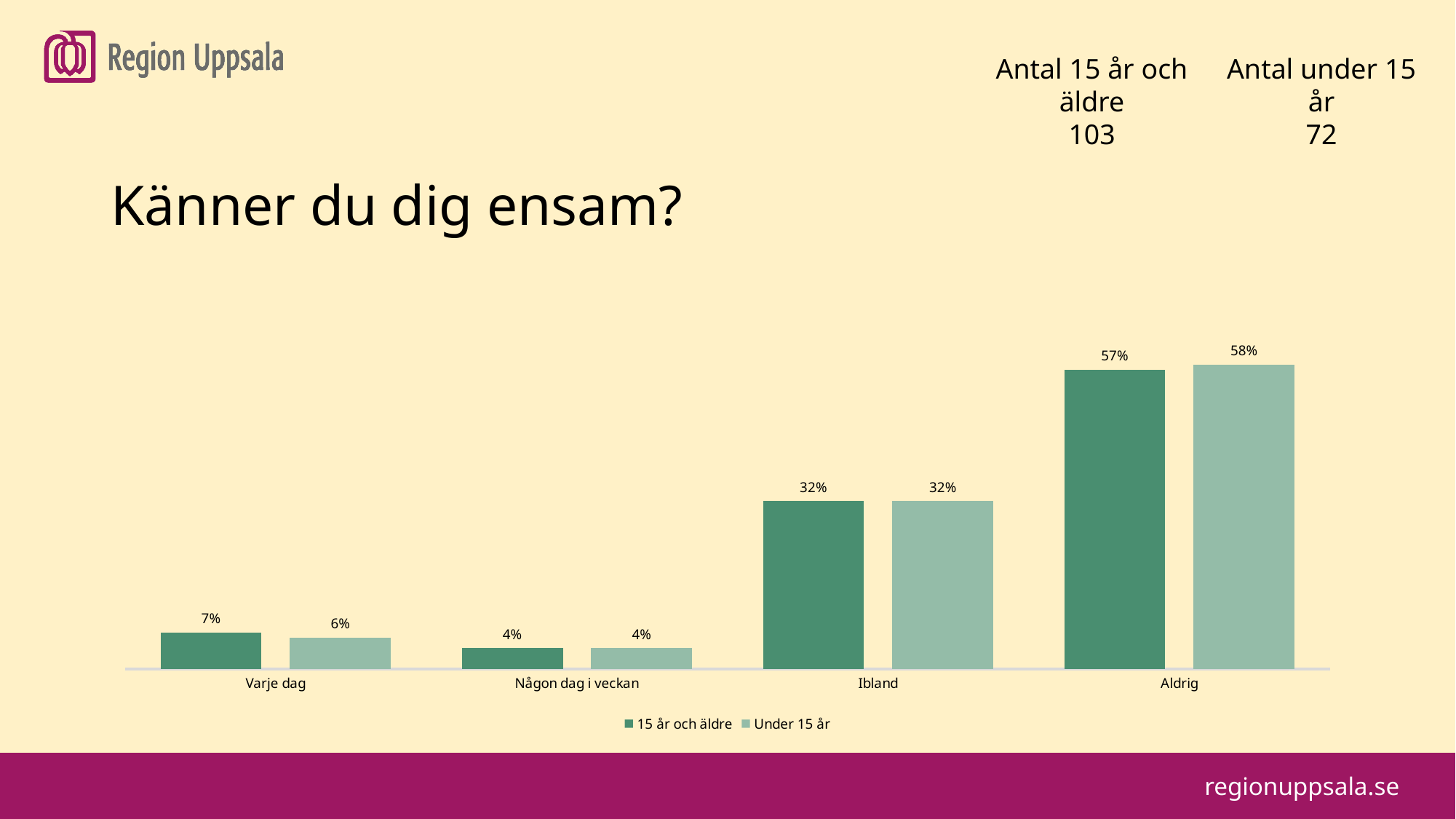
How many series does the legend list? 2 What are the two series named in the legend? 15 år och äldre; Under 15 år What is the difference between the 'Aldrig' and 'Ibland' values for '15 år och äldre'? 25% What is the value for '15 år och äldre' in the 'Aldrig' category? 57% Which category has the lowest value for 'Under 15 år'? Någon dag i veckan How many categories are shown on the x axis? 4 Which is larger: the 'Ibland' value or the 'Varje dag' value for 'Under 15 år'? Ibland Which category has the highest value for '15 år och äldre'? Aldrig What is the value for 'Under 15 år' in the 'Ibland' category? 32% What is the difference between the '15 år och äldre' and 'Under 15 år' values in the 'Varje dag' category? 1% What kind of chart is shown on the slide? Bar chart What is the value for 'Under 15 år' in the 'Varje dag' category? 6%